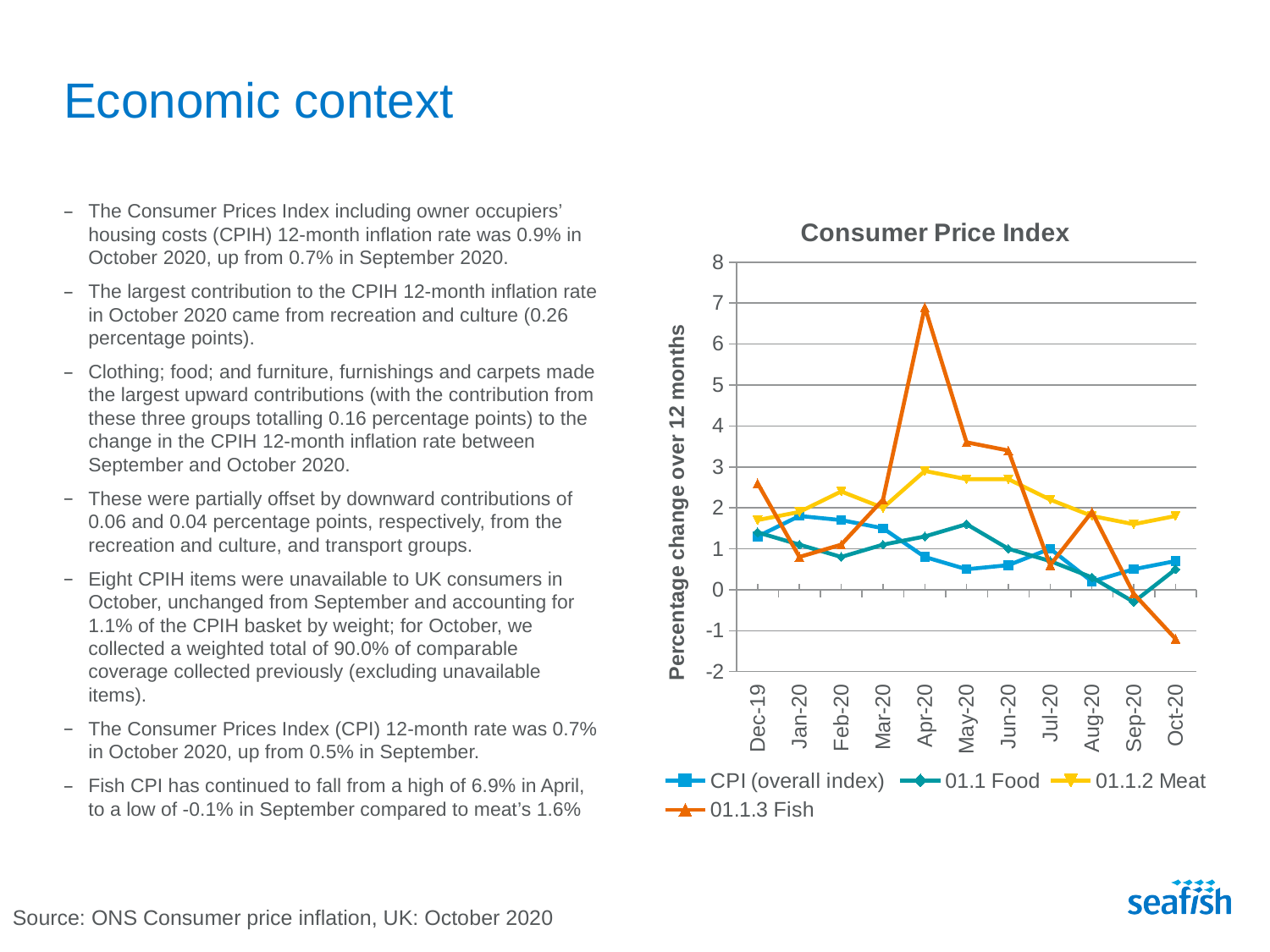
Is the value for 01.1.3 Fish in Apr-20 greater or less than 5? greater In Apr-20, which series has the larger value: 01.1.3 Fish or 01.1.2 Meat? 01.1.3 Fish How many months are plotted along the x axis of the Consumer Price Index chart? 11 Is the value for 01.1.2 Meat in Apr-20 greater or less than 2? greater Is the value for 01.1.3 Fish in Oct-20 greater or less than 0? less Does the 01.1.3 Fish series rise or fall between Apr-20 and Oct-20? Fall In Oct-20, which series has the larger value: 01.1.2 Meat or 01.1.3 Fish? 01.1.2 Meat How many series does the legend of the Consumer Price Index chart list? 4 What kind of chart is shown on the slide? Line chart In which month does the 01.1.3 Fish series reach its lowest value? Oct-20 What is the label on the vertical axis of the Consumer Price Index chart? Percentage change over 12 months In which month does the 01.1.3 Fish series reach its highest value? Apr-20